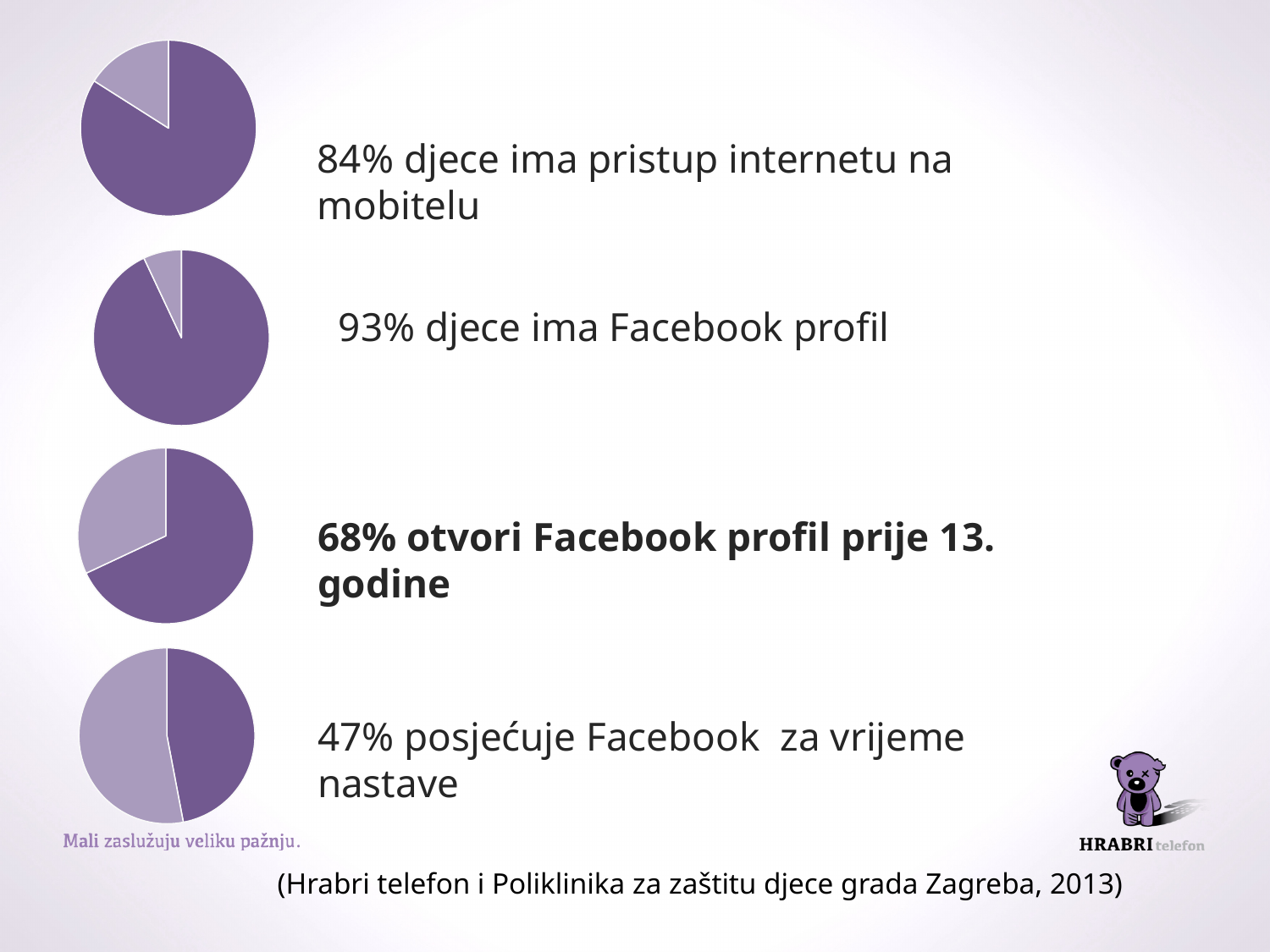
Is the dark slice in the bottom pie chart (47%) larger or smaller than the dark slice in the top pie chart (84%)? Smaller What is the difference between the share of children with a Facebook profile (93%) and the share who visit Facebook during class (47%)? 46% In the second pie chart from the top, what share of children has a Facebook profile? 93% In the top pie chart, what share of children has internet access on a mobile phone (pristup internetu na mobitelu)? 84% What kind of charts are shown on the slide? Pie charts How many pie charts are on the slide? 4 In the bottom pie chart, what share of children visits Facebook during class (za vrijeme nastave)? 47% Which of the four pie charts has the smallest dark purple slice? 47% posjećuje Facebook za vrijeme nastave How many slices does each pie chart on the slide have? 2 Which of the four pie charts has the largest dark purple slice? 93% djece ima Facebook profil